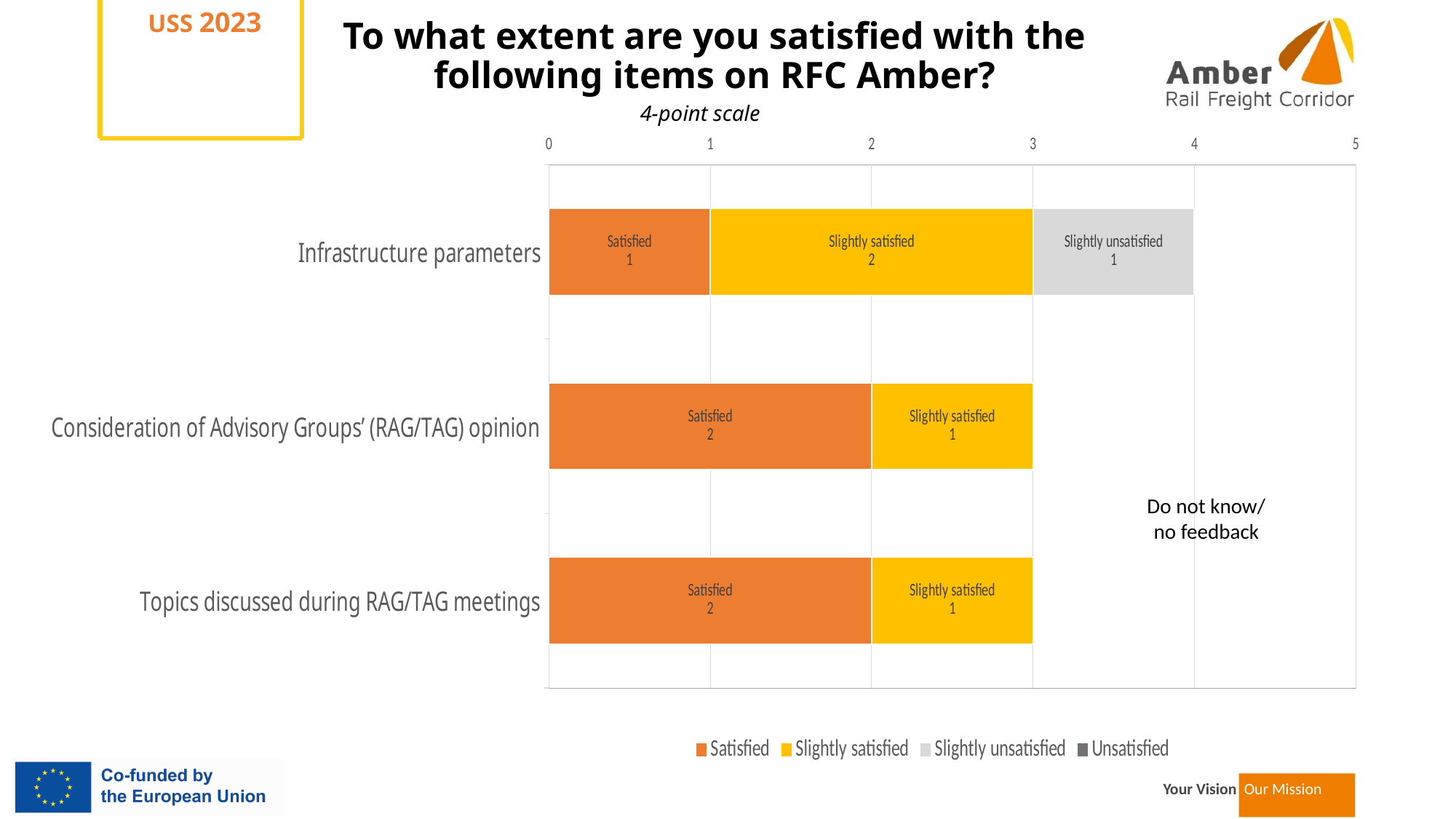
What is the 'Satisfied' value for Infrastructure parameters? 1 What is the 'Slightly unsatisfied' value for Infrastructure parameters? 1 What is the 'Slightly satisfied' value for Topics discussed during RAG/TAG meetings? 1 What is the total of the stacked bar for Topics discussed during RAG/TAG meetings? 3 What is the 'Slightly satisfied' value for Infrastructure parameters? 2 How many series does the legend list? 4 How many categories (items) are shown on the chart? 3 Which series in the legend is shown in grey? Slightly unsatisfied What kind of chart is shown on the slide? Stacked bar chart What is the 'Satisfied' value for Consideration of Advisory Groups' (RAG/TAG) opinion? 2 What is the total of the stacked bar for Infrastructure parameters? 4 Which item has the highest total bar? Infrastructure parameters